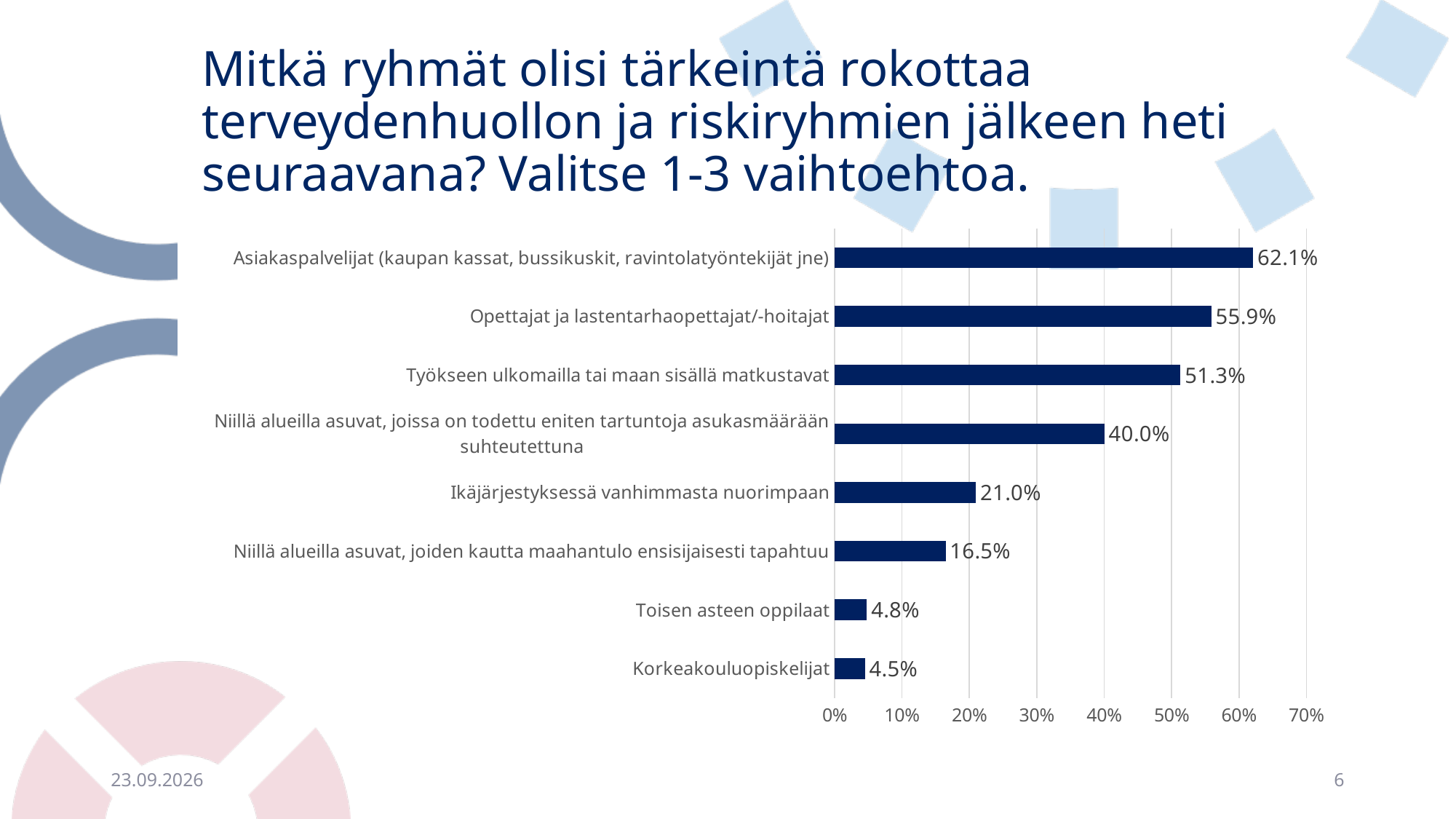
Which is larger: the value for Ikäjärjestyksessä vanhimmasta nuorimpaan or the value for Niillä alueilla asuvat, joiden kautta maahantulo ensisijaisesti tapahtuu? Ikäjärjestyksessä vanhimmasta nuorimpaan What is the highest value shown on the x axis? 70% What is the value for Ikäjärjestyksessä vanhimmasta nuorimpaan? 21.0% Which category has the lowest value? Korkeakouluopiskelijat Is the value for Työkseen ulkomailla tai maan sisällä matkustavat greater or less than 50%? greater What kind of chart is shown on the slide? bar chart How many categories are shown in the chart? 8 Which category has the highest value? Asiakaspalvelijat (kaupan kassat, bussikuskit, ravintolatyöntekijät jne) What is the difference between the values for Työkseen ulkomailla tai maan sisällä matkustavat and Niillä alueilla asuvat, joissa on todettu eniten tartuntoja asukasmäärään suhteutettuna? 11.3% What is the value for Korkeakouluopiskelijat? 4.5% What is the value for Opettajat ja lastentarhaopettajat/-hoitajat? 55.9% What is the value for Asiakaspalvelijat (kaupan kassat, bussikuskit, ravintolatyöntekijät jne)? 62.1%